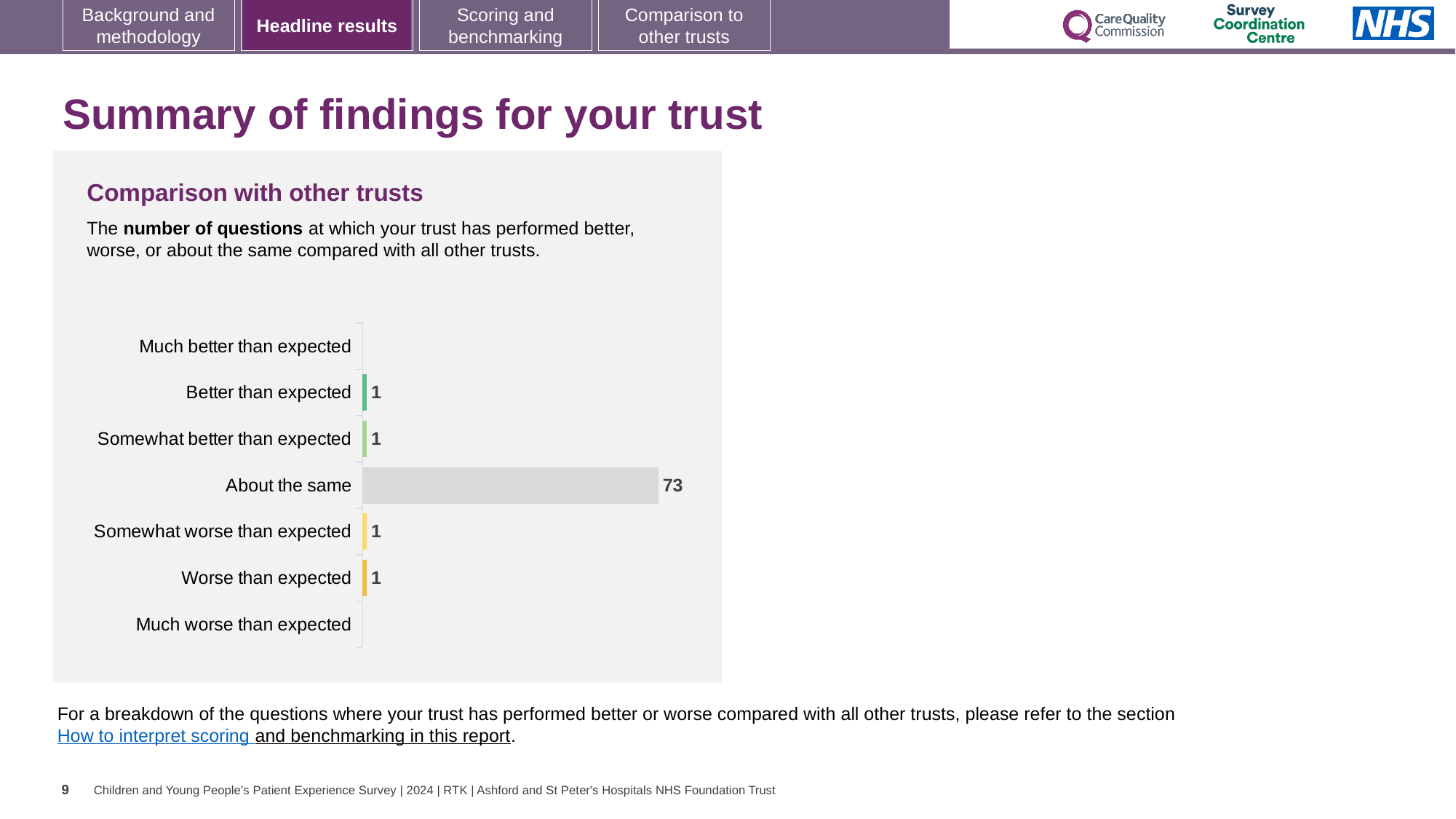
What is the difference between the number of questions rated 'About the same' and those rated 'Better than expected'? 72 How many questions were rated 'About the same'? 73 How many questions were rated 'Somewhat worse than expected'? 1 What colour is the bar for 'About the same'? Grey Which category has the highest number of questions? About the same What kind of chart is shown on the slide? Bar chart How many questions were rated 'Worse than expected'? 1 Which is larger: the number of questions rated 'About the same' or 'Somewhat better than expected'? About the same What is the title of the chart? Comparison with other trusts What is the total number of questions across the 'Better than expected', 'Somewhat better than expected', 'Somewhat worse than expected' and 'Worse than expected' categories? 4 How many categories are shown on the chart? 7 How many questions were rated 'Better than expected'? 1